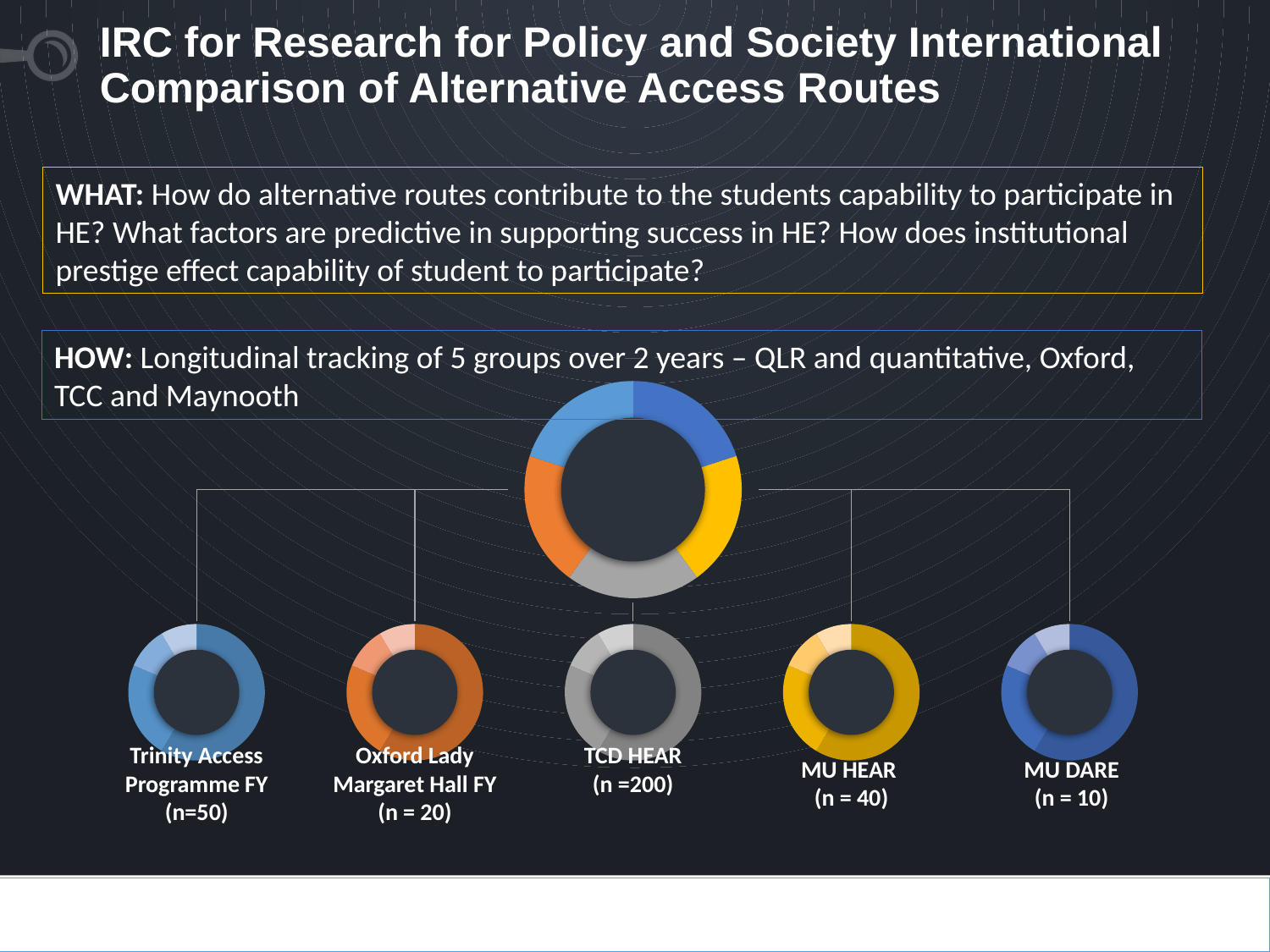
Is the sample size for MU HEAR larger or smaller than the sample size for Oxford Lady Margaret Hall FY? Larger What sample size is shown in the label of the Trinity Access Programme FY doughnut chart? n=50 What sample size is shown in the label of the TCD HEAR doughnut chart? n =200 What kind of chart is the large chart in the centre of the slide? Doughnut chart In the TCD HEAR doughnut chart, which segment is larger, the dark grey or the light grey? Dark grey What is the difference between the sample sizes of TCD HEAR and Trinity Access Programme FY? 150 What sample size is shown in the label of the MU DARE doughnut chart? n = 10 What colour is the doughnut chart labelled Oxford Lady Margaret Hall FY? Orange What sample size is shown in the label of the Oxford Lady Margaret Hall FY doughnut chart? n = 20 How many small doughnut charts are shown in the row at the bottom of the slide? 5 Which of the five labelled groups has the largest sample size (n)? TCD HEAR Which of the five labelled groups has the smallest sample size (n)? MU DARE